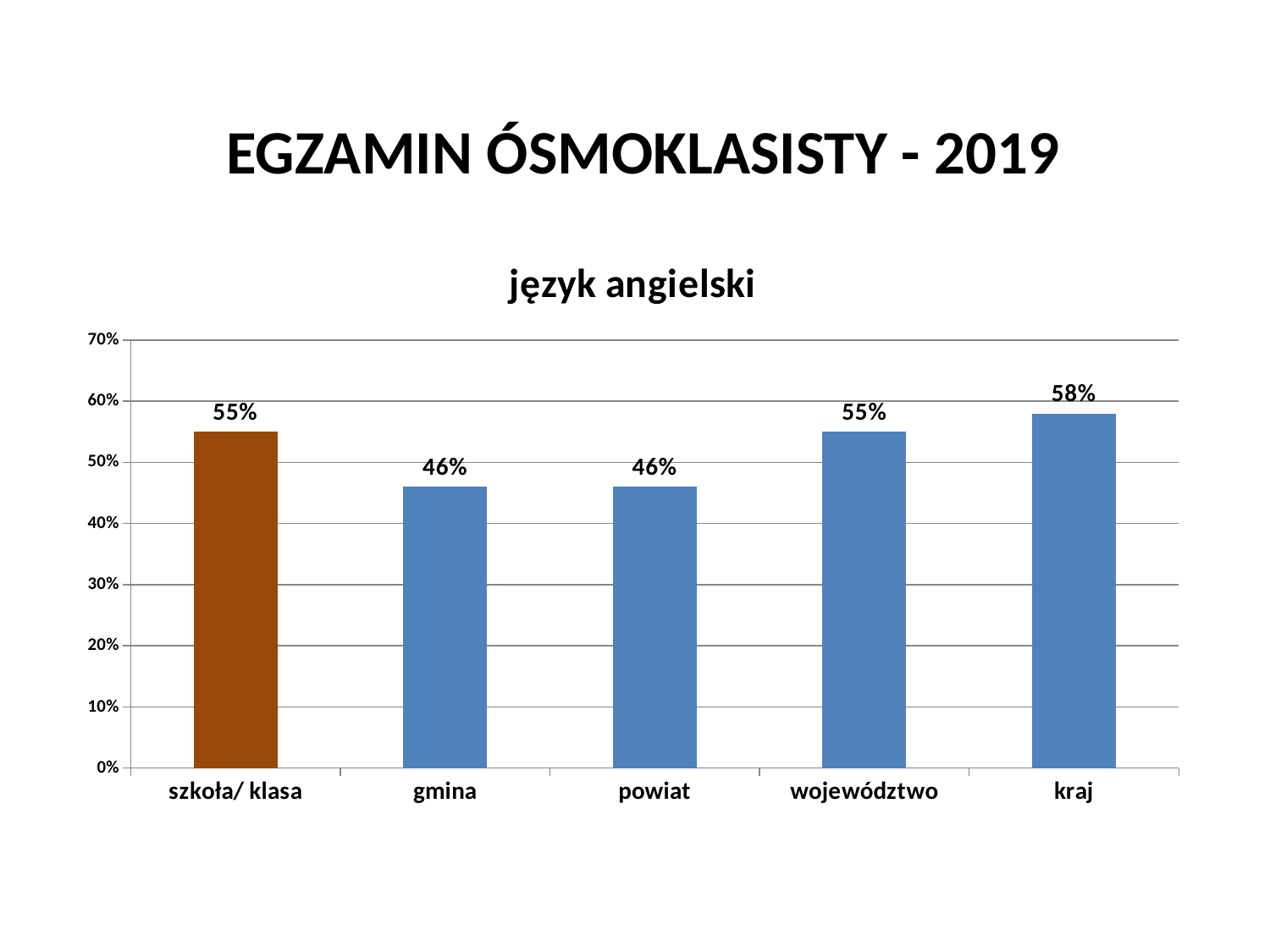
Is the value for powiat greater or less than 50%? less What is the value for szkoła/ klasa? 55% What is the value for województwo? 55% Which is larger, the value for szkoła/ klasa or the value for gmina? szkoła/ klasa What is the difference between the values for kraj and gmina? 12% What is the title of the chart? język angielski Which category has the highest value? kraj What is the value for kraj? 58% What is the value for gmina? 46% What kind of chart is shown on the slide? bar chart How many categories are shown on the x axis? 5 What is the difference between the values for szkoła/ klasa and powiat? 9%